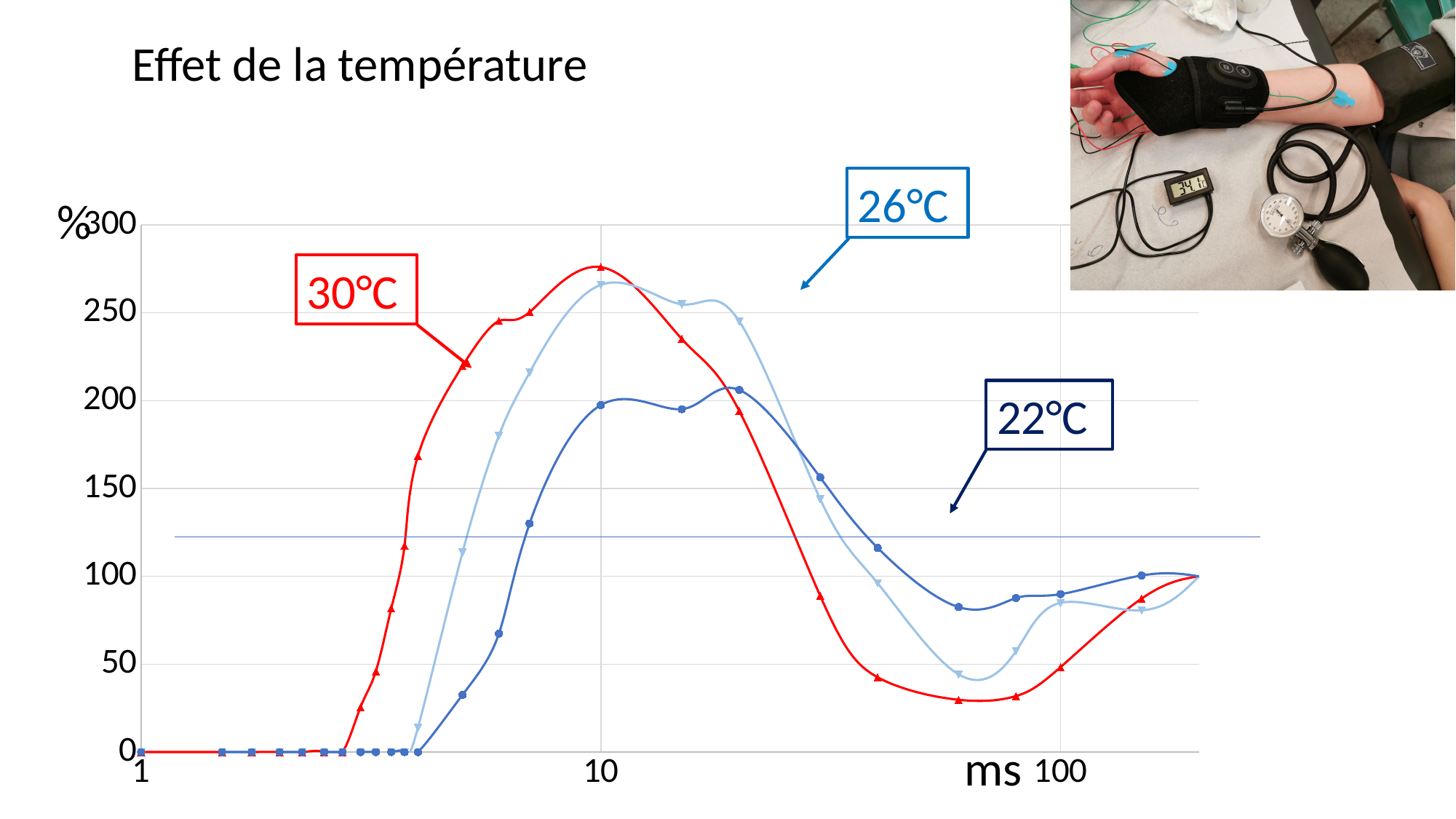
What unit is shown on the x axis of the chart? ms What value do all three series have at 1 ms? 0 Between 1 ms and 10 ms, does the 30°C series rise or fall? rise Is the peak value of the 30°C series greater or less than 250? greater Which temperature series has the lowest peak value? 22°C Is the peak value of the 22°C series greater or less than 250? less How many series (temperature curves) are plotted on the chart? 3 What kind of chart is shown on the slide? line chart What is the title of the chart on the slide? Effet de la température Which temperature series reaches the highest peak value? 30°C At 10 ms, which series has the larger value, 30°C or 22°C? 30°C Which temperature series dips to the lowest value between 10 ms and 100 ms? 30°C